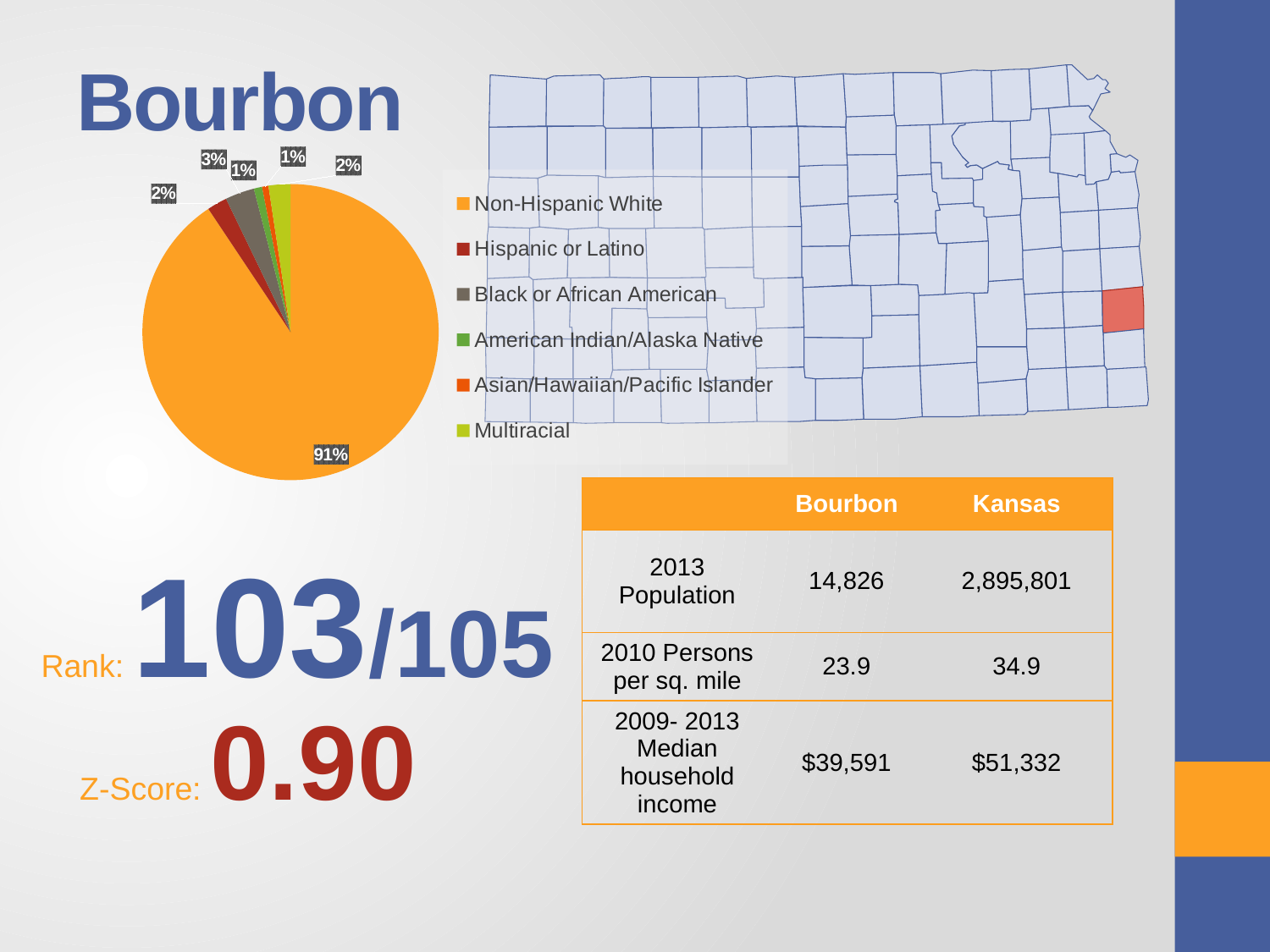
Which category has the largest slice of the pie chart? Non-Hispanic White What is the value shown for Black or African American in the pie chart? 3% What is the value shown for Hispanic or Latino in the pie chart? 2% How many categories does the pie chart show? 6 What share of the pie does Non-Hispanic White represent? 91% Which is larger in the pie chart, Black or African American or American Indian/Alaska Native? Black or African American What is the title shown above the pie chart? Bourbon Which is larger in the pie chart, Non-Hispanic White or Black or African American? Non-Hispanic White What colour is used for Non-Hispanic White in the pie chart? orange What kind of chart is shown on the slide? pie chart What is the difference in percentage points between Non-Hispanic White and Black or African American? 88 What is the value shown for Multiracial in the pie chart? 2%